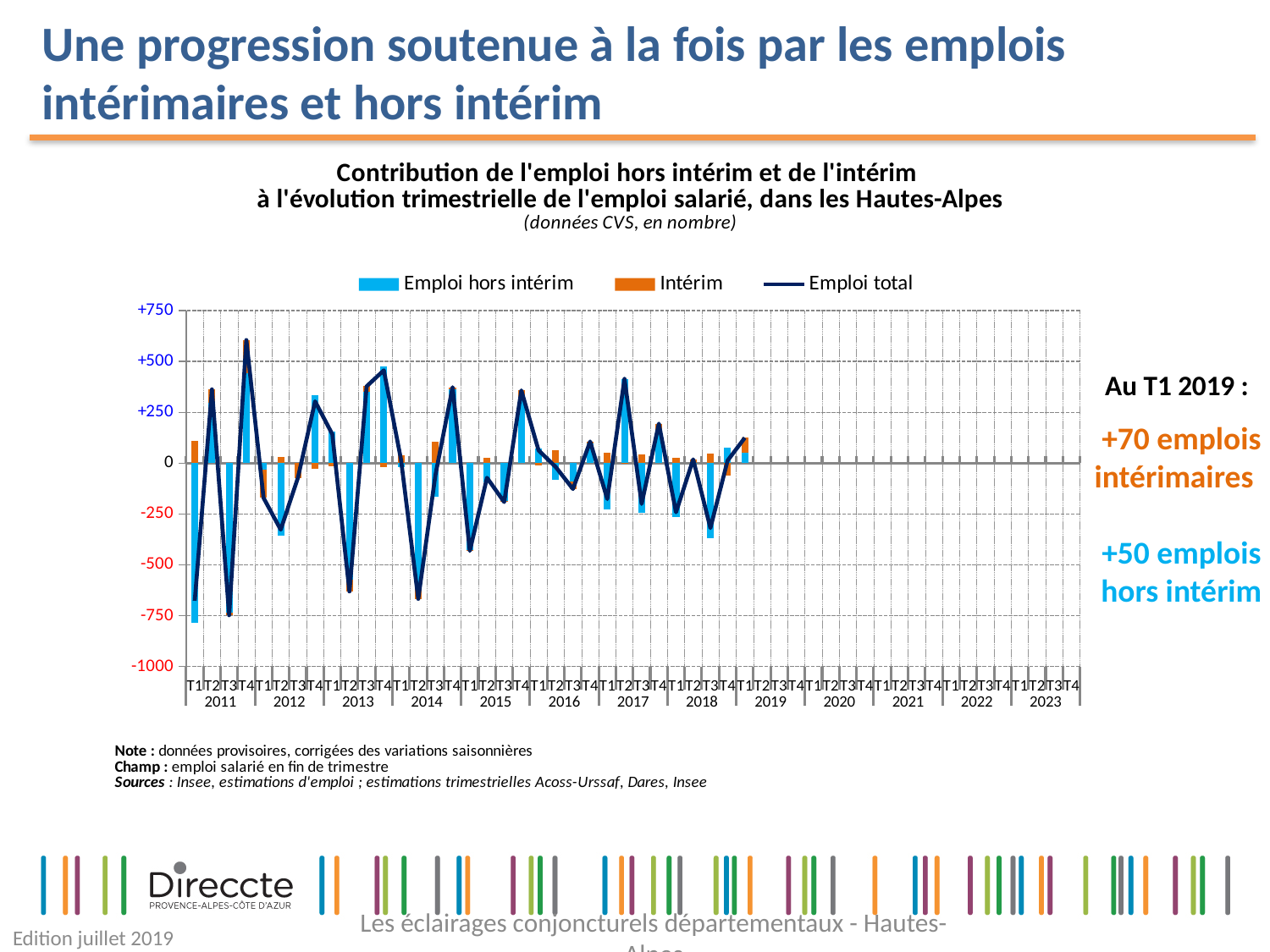
At T1 2019, which is larger: the Intérim contribution or the Emploi hors intérim contribution? Intérim Is the Emploi total value for T4 2011 greater or less than +500? greater What kind of chart is shown on the slide? A combined bar and line chart What is the difference between the Intérim (+70) and Emploi hors intérim (+50) contributions at T1 2019? 20 How many years are labeled on the x axis of the chart? 13 In which quarter does the Emploi total line reach its highest value? T4 2011 Is the Emploi total value for T1 2014 greater or less than -500? greater According to the annotation, what is the value for Emploi hors intérim at T1 2019? +50 According to the annotation, what is the value for Intérim at T1 2019? +70 How many series does the chart legend list? 3 What is the total of the Intérim (+70) and Emploi hors intérim (+50) contributions at T1 2019? 120 Which colour represents the Intérim series in the chart? Orange